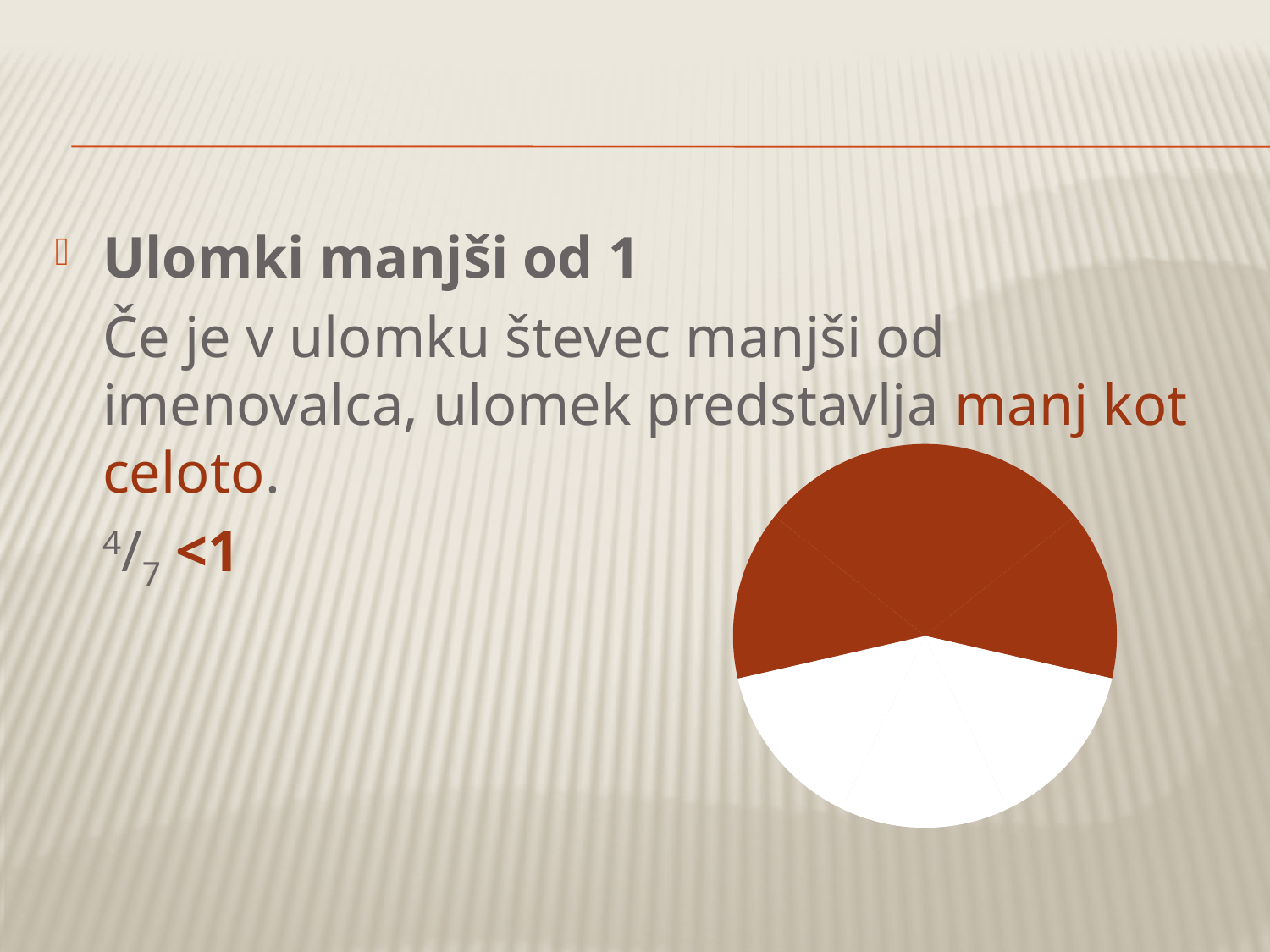
What kind of chart is shown on the slide? pie chart How many slices of the pie chart are shaded dark red? 4 Does the shaded part of the pie chart represent more or less than the whole? less What fraction of the pie chart is shaded dark red? 4/7 Which part of the pie chart is larger, the dark red part or the white part? the dark red part How many slices is the pie chart divided into? 7 How many slices of the pie chart are left white? 3